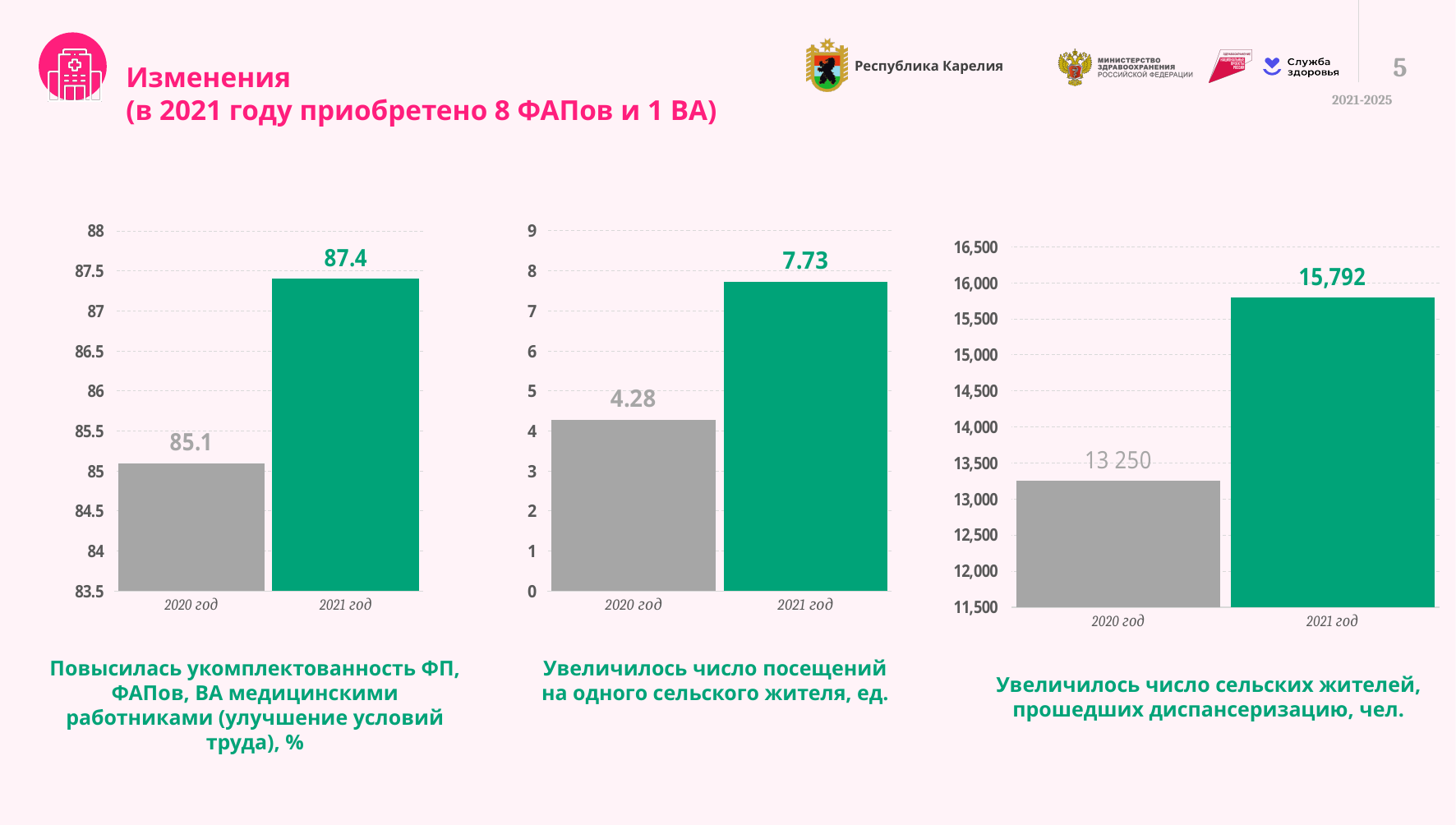
What type of chart is the left chart? bar chart In the right chart, which year has the lower value? 2020 год In the left chart, what is the value for 2021 год? 87.4 How many bars does the right chart have? 2 In the right chart, what is the value for 2021 год? 15,792 In the right chart, what is the value for 2020 год? 13 250 In the left chart, what is the value for 2020 год? 85.1 In the middle chart, what is the value for 2020 год? 4.28 In the middle chart, what is the value for 2021 год? 7.73 In the middle chart, what is the difference between the 2021 год and 2020 год values? 3.45 In the middle chart, which year has the higher value? 2021 год In the left chart, what is the difference between the 2021 год and 2020 год values? 2.3